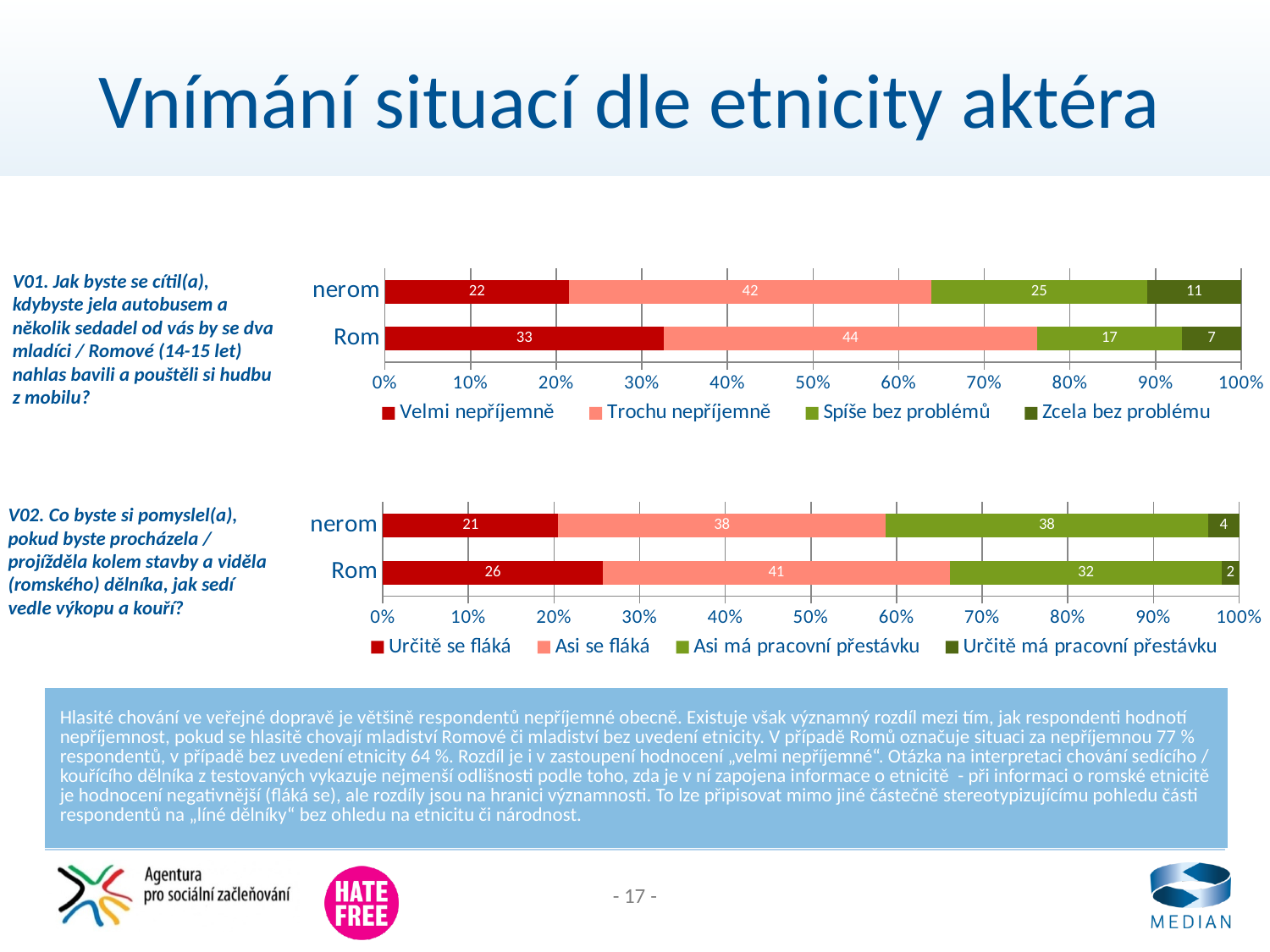
In the top chart (V01), what is the value of 'Velmi nepříjemně' for the 'Rom' bar? 33 In the top chart (V01), what is the value of 'Trochu nepříjemně' for the 'nerom' bar? 42 In the bottom chart (V02), what is the value of 'Určitě má pracovní přestávku' for the 'nerom' bar? 4 In the top chart (V01), what is the value of 'Zcela bez problému' for the 'Rom' bar? 7 How many categories (bars) does the top chart (V01) show? 2 How many series does the legend of the bottom chart (V02) list? 4 What kind of chart is the top chart (V01)? Stacked bar chart In the bottom chart (V02), which segment of the 'nerom' bar is the smallest? Určitě má pracovní přestávku In the bottom chart (V02), what is the difference between the 'Asi má pracovní přestávku' values for 'nerom' and 'Rom'? 6 In the top chart (V01), which bar has the larger 'Spíše bez problémů' value, 'nerom' or 'Rom'? nerom In the top chart (V01), what is the difference between the 'Velmi nepříjemně' values for 'Rom' and 'nerom'? 11 In the bottom chart (V02), what is the value of 'Asi se fláká' for the 'Rom' bar? 41